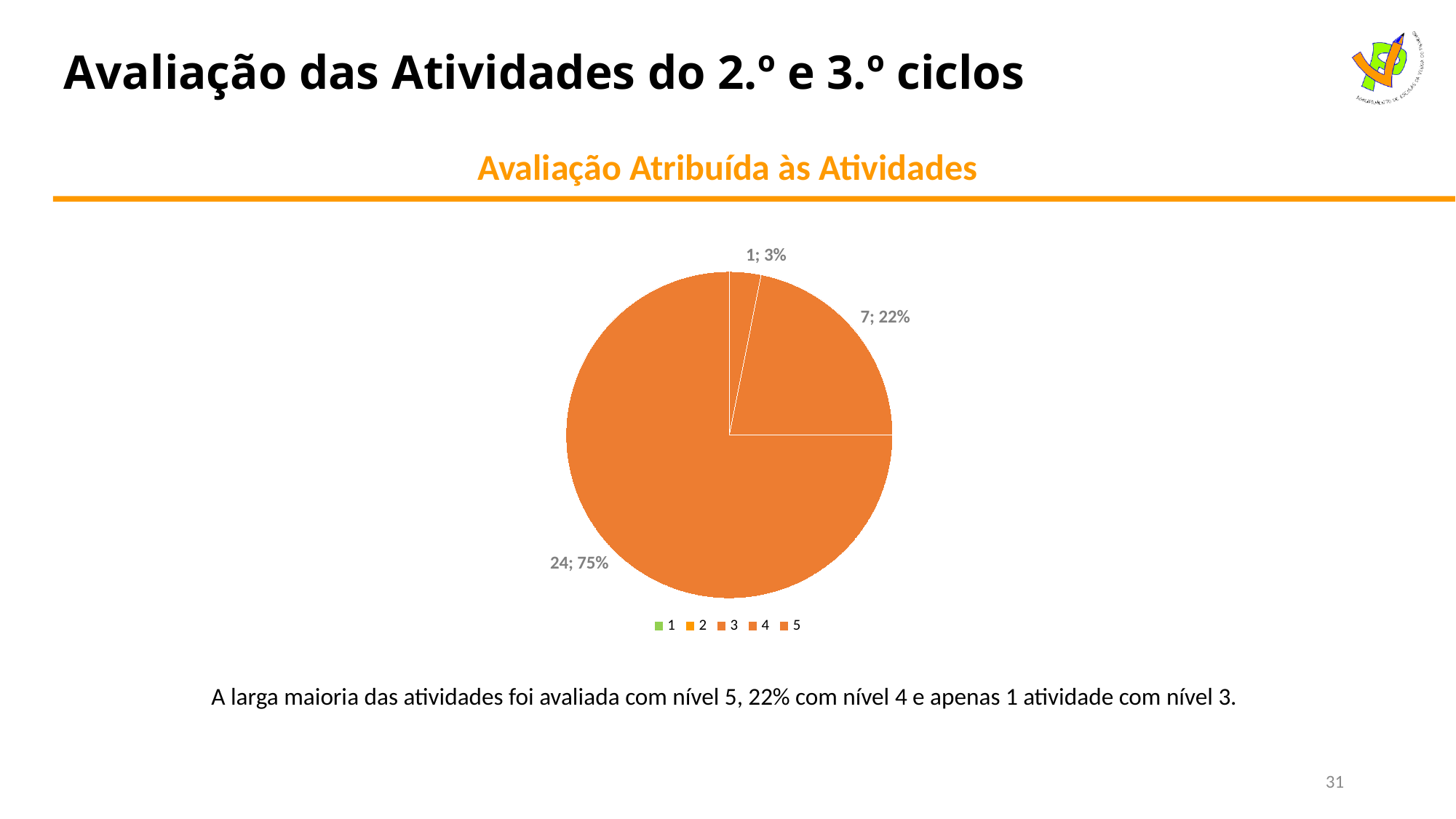
What count is shown for the largest slice of the pie chart? 24 How many slices with data labels are visible in the pie chart? 3 What percentage share does the largest slice of the pie chart have? 75% What is the difference in count between the slice labelled 24 and the slice labelled 7? 17 What is the count for the slice labelled with 22%? 7 Which slice is larger: the one labelled 7; 22% or the one labelled 1; 3%? 7; 22% What kind of chart is shown on the slide? Pie chart How many entries does the chart legend list? 5 What is the title of the chart? Avaliação Atribuída às Atividades What count is shown for the smallest slice of the pie chart? 1 What percentage share does the smallest slice of the pie chart have? 3% According to the slide, how many activities were rated at level 3? 1